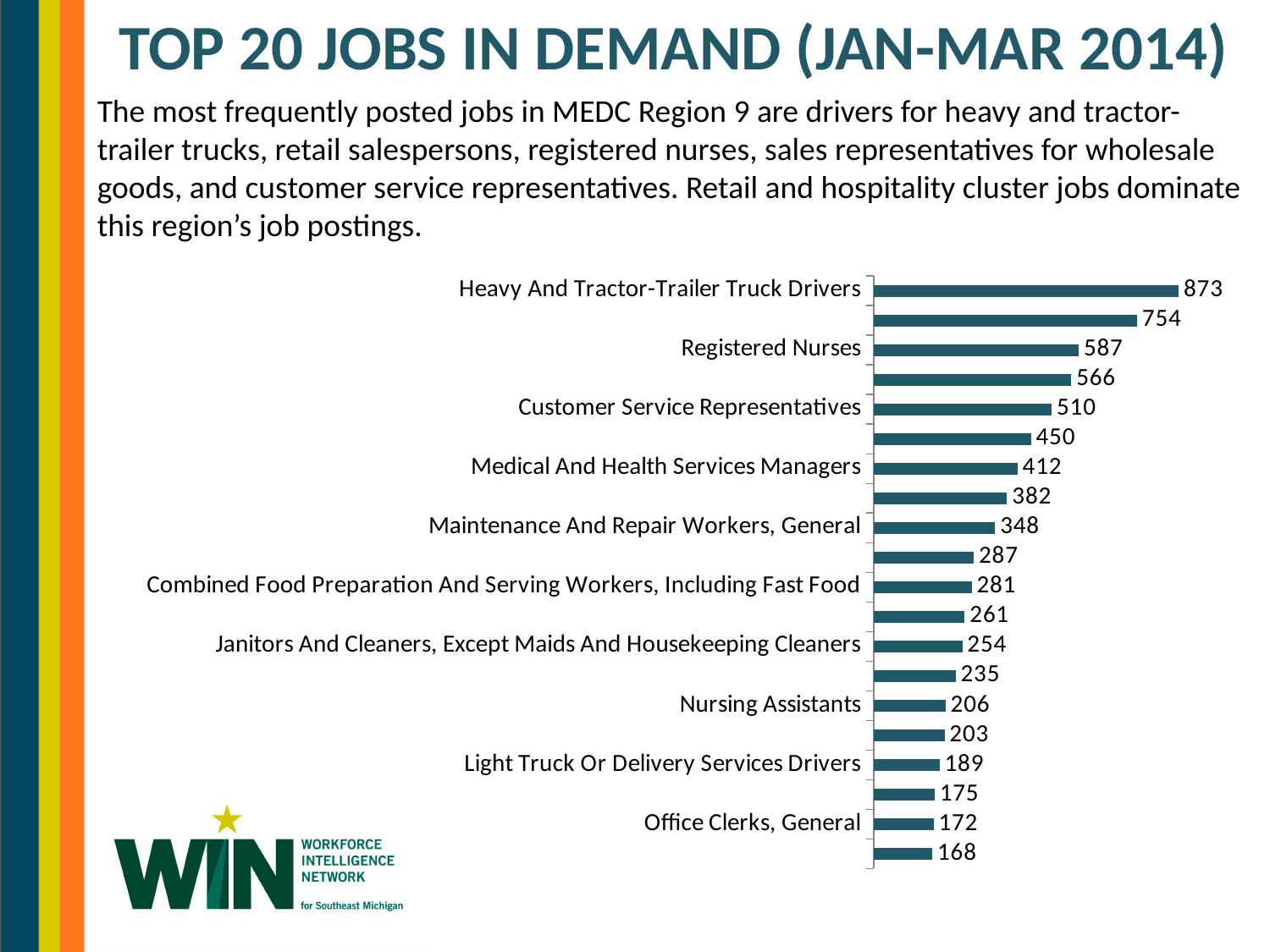
How many bars are plotted in the chart? 20 What is the value for Registered Nurses? 587 What is the value for Heavy And Tractor-Trailer Truck Drivers? 873 What is the value for Office Clerks, General? 172 What kind of chart is shown on the slide? Bar chart Which job has the highest value in the chart? Heavy And Tractor-Trailer Truck Drivers Which is larger, the value for Nursing Assistants or the value for Light Truck Or Delivery Services Drivers? Nursing Assistants What is the difference between the values for Maintenance And Repair Workers, General and Combined Food Preparation And Serving Workers, Including Fast Food? 67 What is the difference between the values for Heavy And Tractor-Trailer Truck Drivers and Registered Nurses? 286 What is the smallest value shown in the chart? 168 What is the value for Customer Service Representatives? 510 What is the value for Medical And Health Services Managers? 412